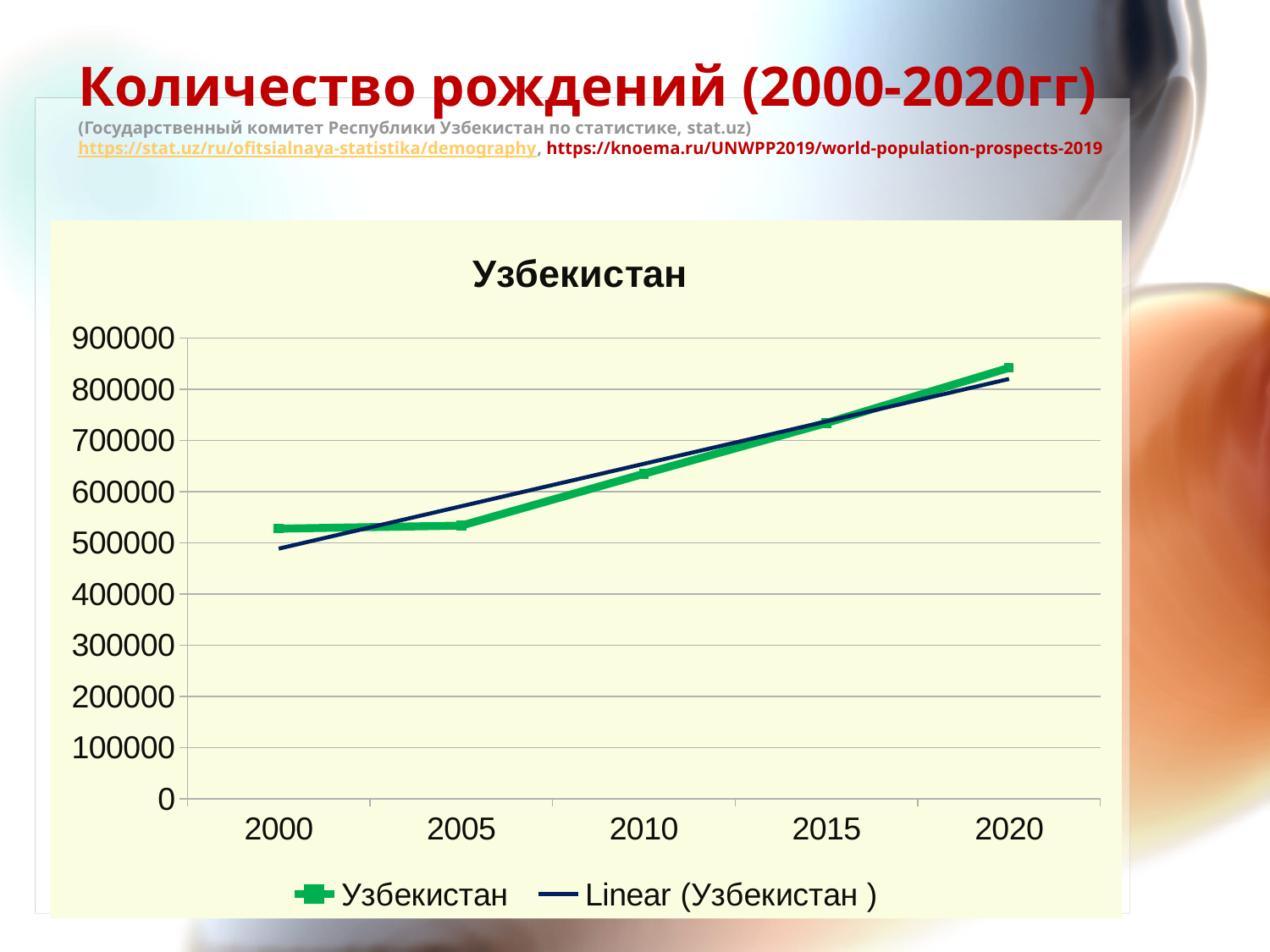
Is the value for 2015 in the Узбекистан series greater or less than 800000? less What are the two entries in the chart legend? Узбекистан and Linear (Узбекистан ) Is the value for 2020 in the Узбекистан series greater or less than 800000? greater What is the title of the chart? Узбекистан Which is larger in the Узбекистан series, the value for 2010 or the value for 2015? 2015 Do the values of the Узбекистан series rise or fall from 2000 to 2020? rise What kind of chart is shown on the slide? line chart Which year has the highest number of births in the Узбекистан series? 2020 Is the value for 2010 in the Узбекистан series greater or less than 600000? greater How many series does the legend list? 2 How many years are plotted along the x axis? 5